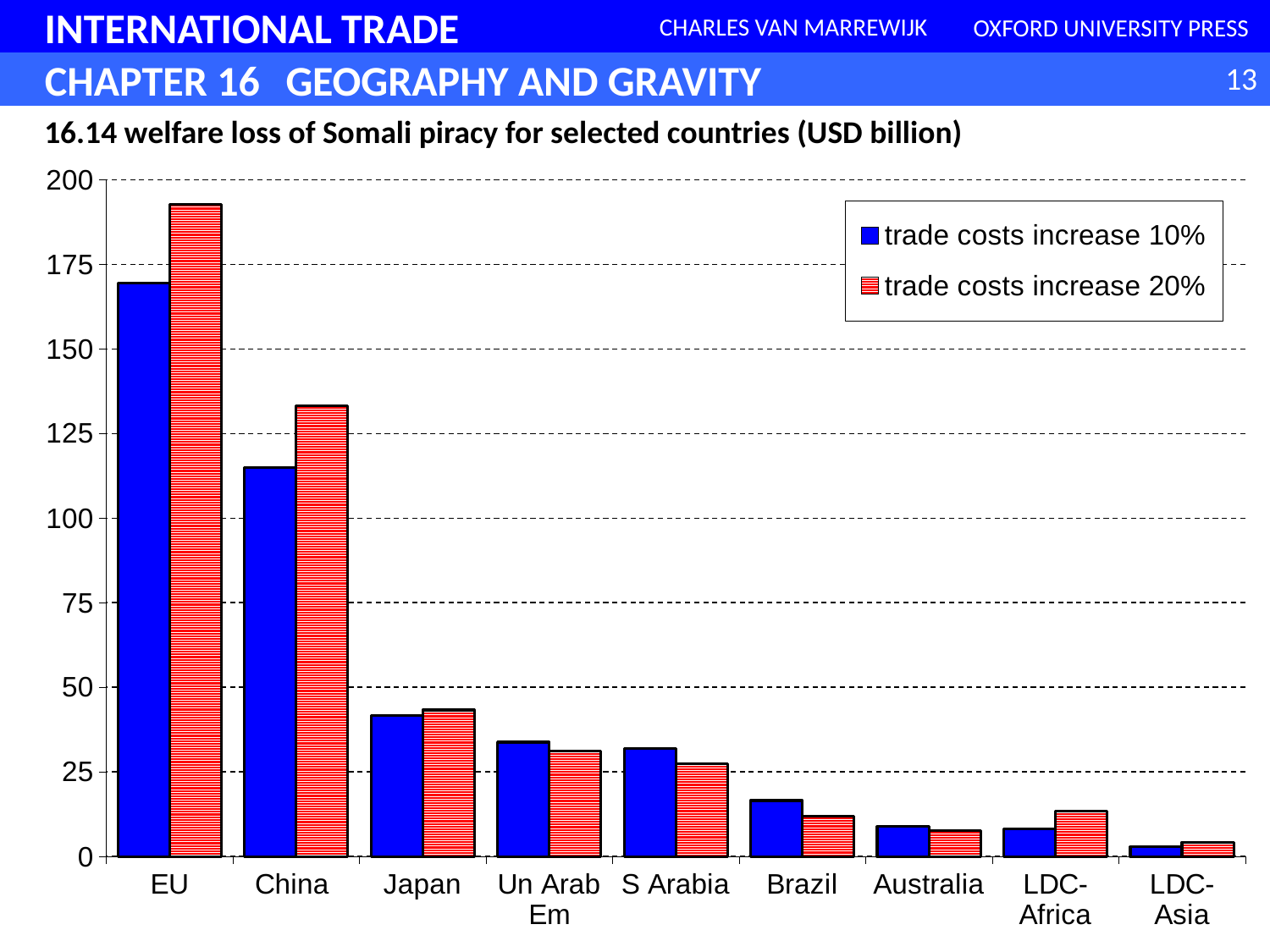
Do the 'trade costs increase 10%' values generally rise or fall moving from EU on the left to LDC-Asia on the right? fall Which country has the lowest welfare loss for the 'trade costs increase 10%' series? LDC-Asia Is the 'trade costs increase 20%' value for China greater or less than 125? greater What kind of chart is shown on the slide? bar chart Is the 'trade costs increase 20%' value for EU greater or less than 175? greater How many series does the legend list? 2 How many countries or regions are shown on the x axis? 9 Is the 'trade costs increase 10%' value for Japan greater or less than 50? less For China, which is larger: the 'trade costs increase 10%' value or the 'trade costs increase 20%' value? trade costs increase 20% Which country has the highest welfare loss for the 'trade costs increase 20%' series? EU For Brazil, which is larger: the 'trade costs increase 10%' value or the 'trade costs increase 20%' value? trade costs increase 10%